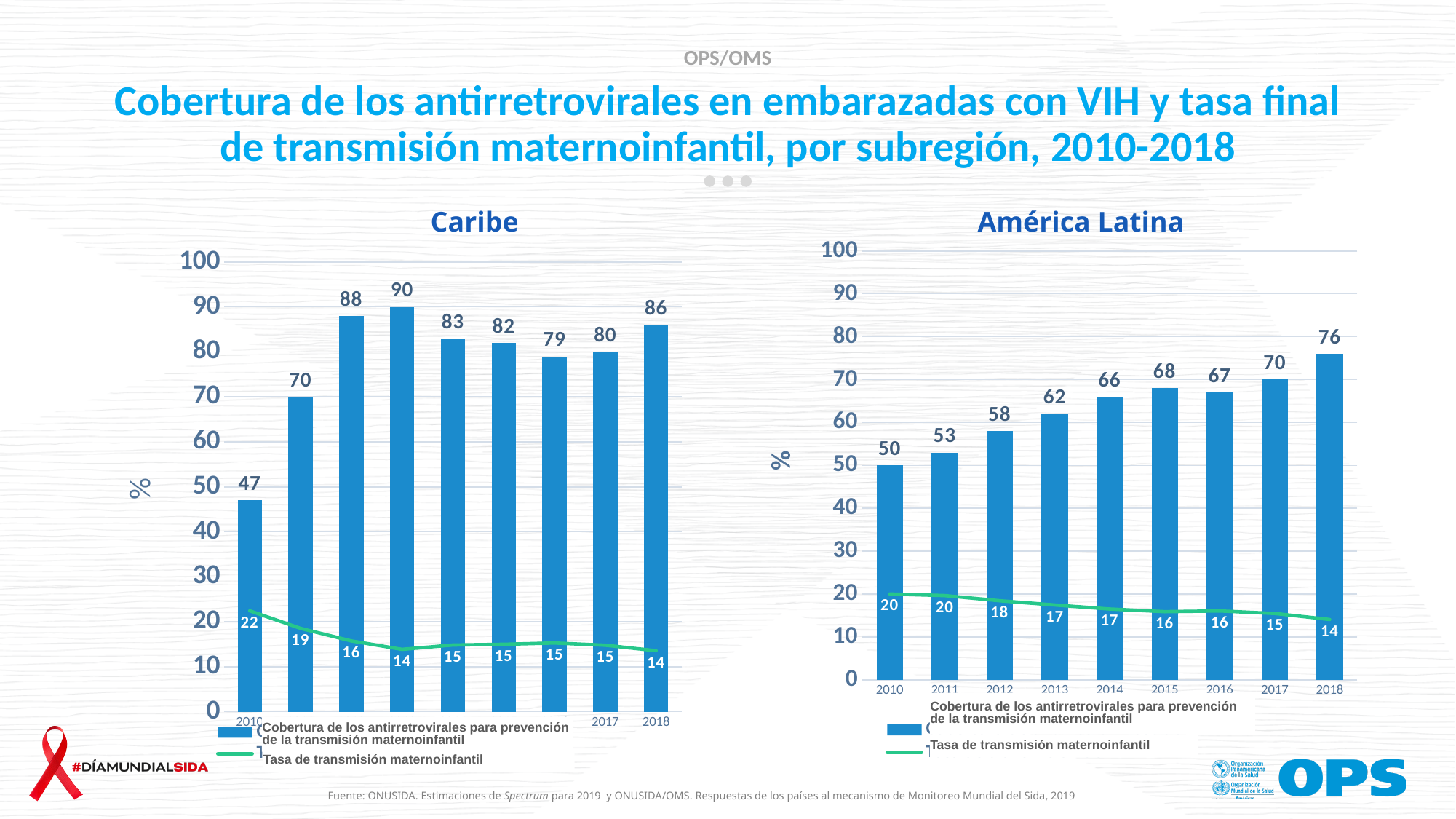
In the América Latina chart, which year has higher antiretroviral coverage, 2014 or 2017? 2017 In the América Latina chart, what is the transmission rate for 2018? 14 In the América Latina chart, does the transmission rate line rise or fall from 2010 to 2018? fall How many years are plotted in the América Latina chart? 9 In the América Latina chart, what is the difference in antiretroviral coverage between 2016 and 2015? 1 In the Caribe chart, what is the antiretroviral coverage value for 2018? 86 In the Caribe chart, what is the mother-to-child transmission rate for 2010? 22 How many series does the legend of the Caribe chart list? 2 In the América Latina chart, which year has the lowest antiretroviral coverage? 2010 In the Caribe chart, what is the difference in antiretroviral coverage between 2018 and 2010? 39 In the América Latina chart, what is the antiretroviral coverage value for 2013? 62 In the América Latina chart, which year has the highest antiretroviral coverage? 2018